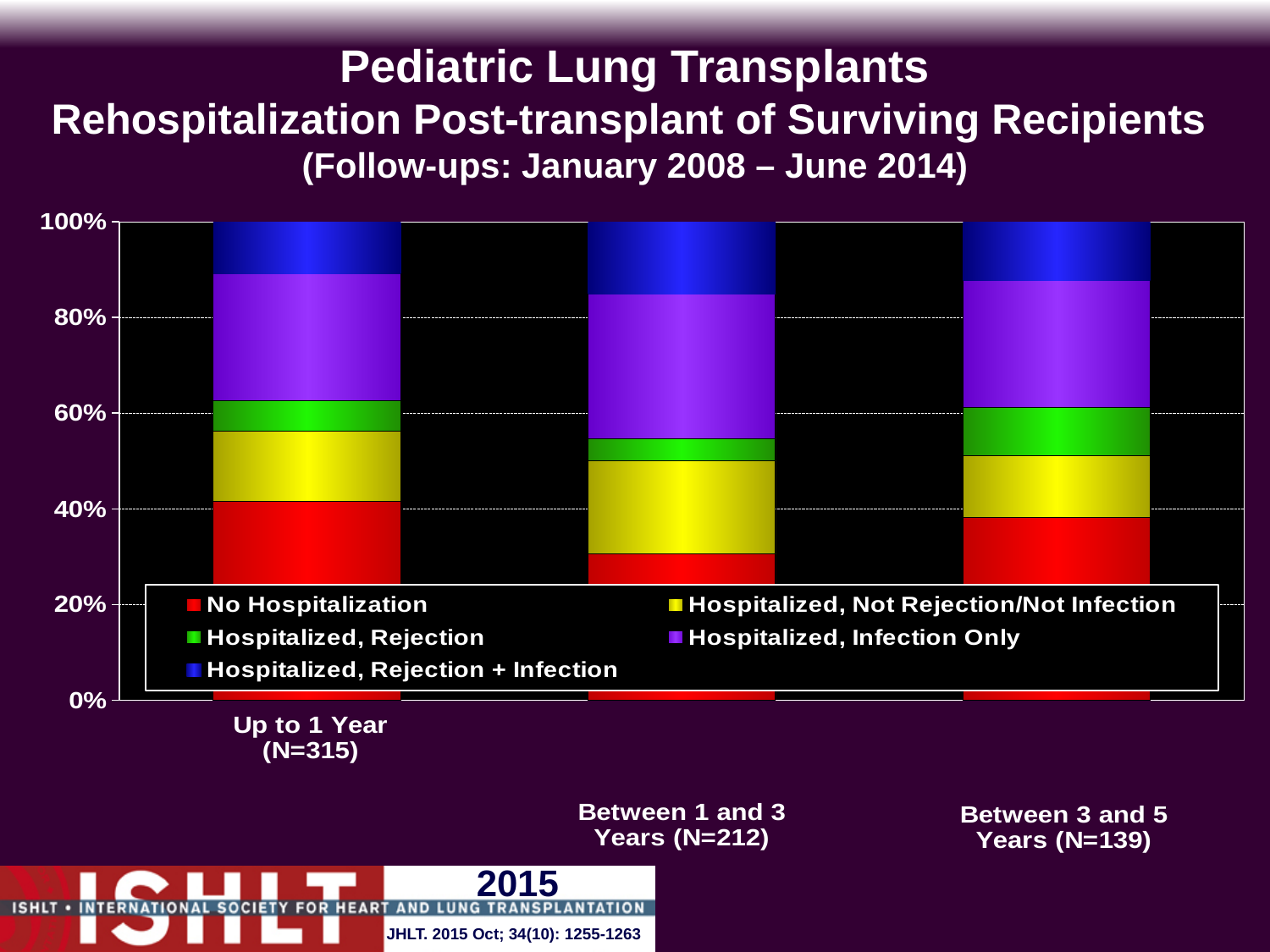
Which follow-up category has the smallest No Hospitalization share? Between 1 and 3 Years (N=212) Is the No Hospitalization share for Between 1 and 3 Years greater or less than 40%? less Is the No Hospitalization share for Between 1 and 3 Years greater or less than 20%? greater Which has the larger Hospitalized, Rejection segment: Between 1 and 3 Years or Between 3 and 5 Years? Between 3 and 5 Years Which has the larger No Hospitalization share: Up to 1 Year or Between 1 and 3 Years? Up to 1 Year What is the N shown for the Between 1 and 3 Years category? 212 How many follow-up time categories are shown on the x axis? 3 Which colour represents No Hospitalization in the legend? Red Which follow-up category has the largest Hospitalized, Rejection + Infection segment? Between 1 and 3 Years (N=212) What kind of chart is shown on the slide? Stacked bar chart How many series does the legend list? 5